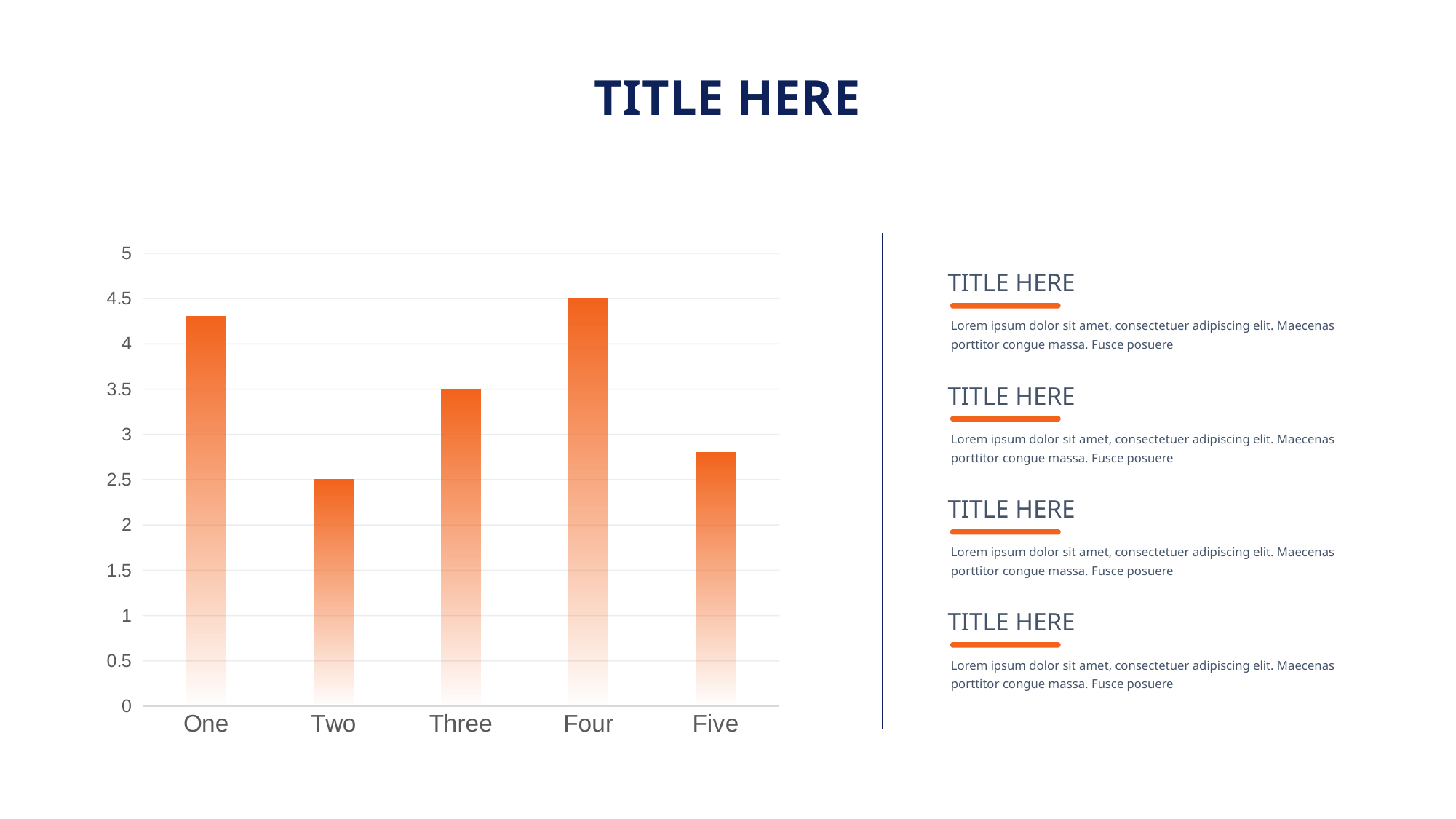
What is the difference between the values for Four and Two? 2 What is the value for Three? 3.5 Is the value for One greater or less than 4? greater What is the value for Four? 4.5 What is the difference between the values for Four and Three? 1 Is the value for Five greater or less than 3? less How many categories are shown on the x axis? 5 What is the value for Two? 2.5 Which category has the highest value? Four What kind of chart is shown on the slide? bar chart Which category has the lowest value? Two Which is larger, the value for One or the value for Five? One